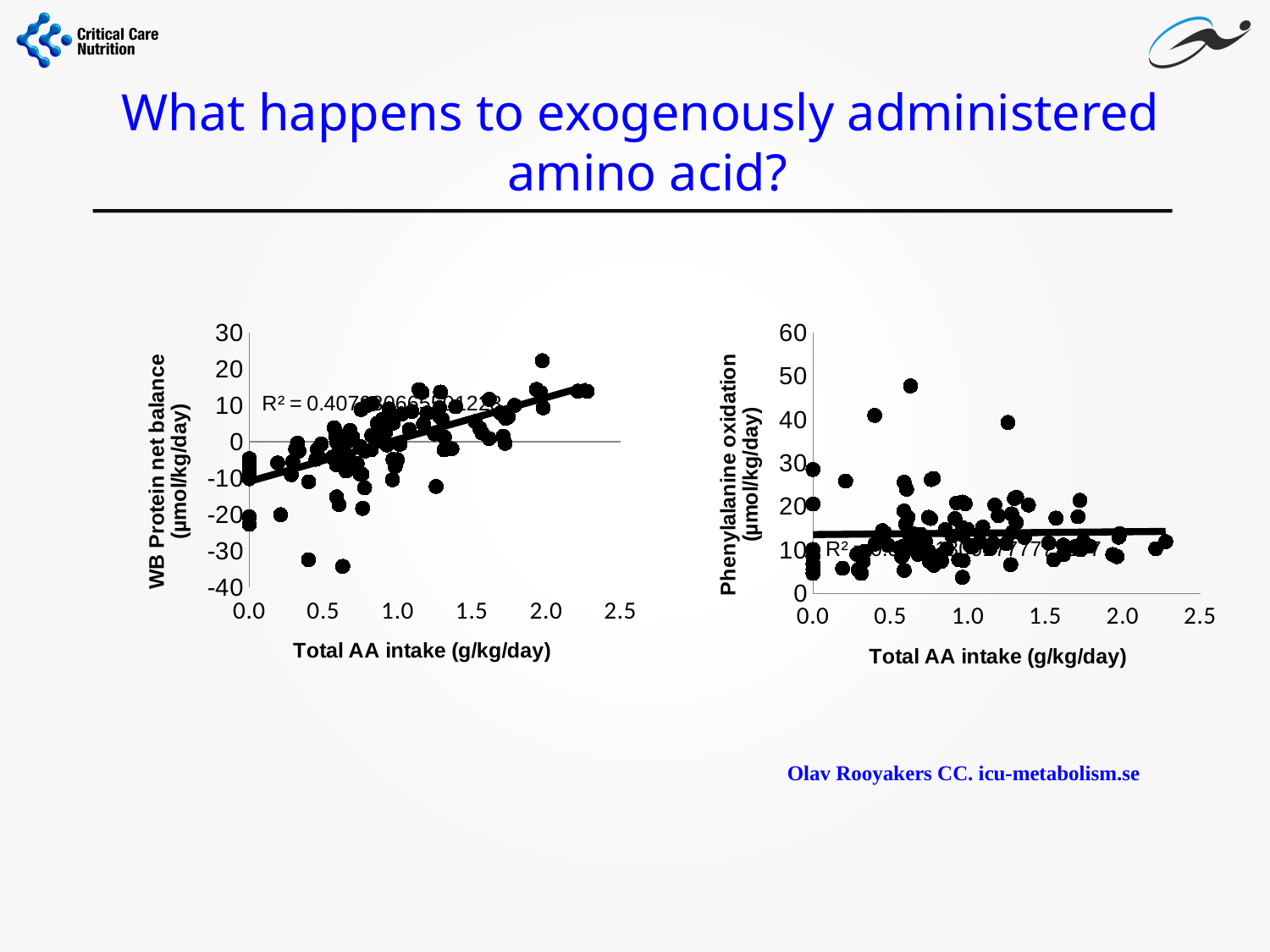
In the left chart, is the highest plotted WB Protein net balance value greater or less than 10? greater In the right chart, is the lowest plotted Phenylalanine oxidation value greater or less than 10? less What is the minimum value shown on the y axis of the left chart? -40 In the right chart, does the fitted trend line for Phenylalanine oxidation rise steeply, fall steeply, or stay roughly flat as Total AA intake increases? roughly flat What is the x-axis label of the left chart? Total AA intake (g/kg/day) What is the maximum value shown on the y axis of the right chart? 60 What kind of chart is the right chart (Phenylalanine oxidation)? scatter chart What is the y-axis label of the right chart? Phenylalanine oxidation (µmol/kg/day) In the left chart, is the lowest plotted WB Protein net balance value greater or less than -30? less What kind of chart is the left chart (WB Protein net balance)? scatter chart In the left chart, does WB Protein net balance rise or fall as Total AA intake increases along the x axis? rise